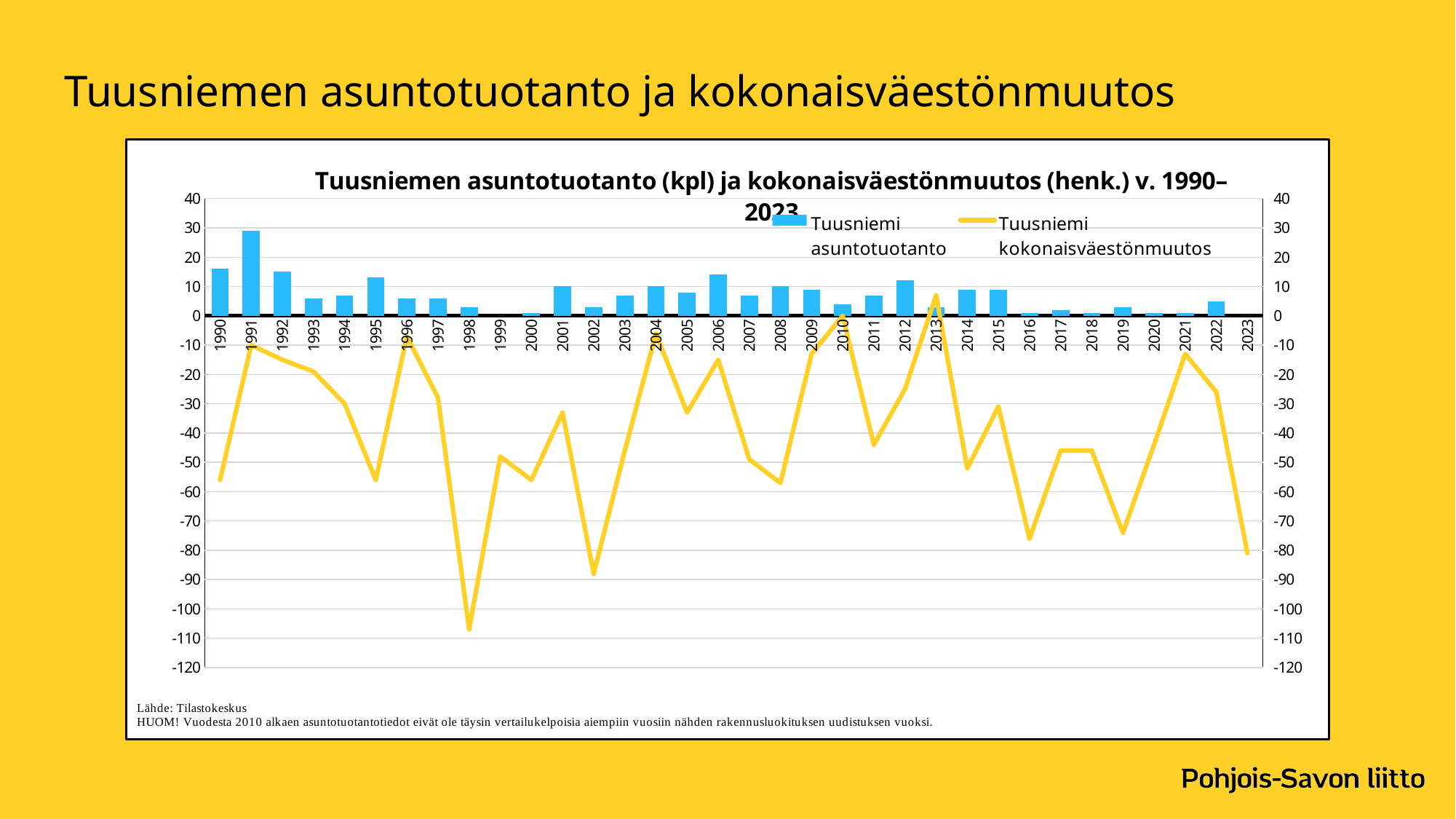
Is the Tuusniemi kokonaisväestönmuutos value for 2023 greater or less than -70? less Which year has the larger Tuusniemi asuntotuotanto bar, 2006 or 2007? 2006 In which year does the Tuusniemi kokonaisväestönmuutos line reach its highest point? 2013 In which year does the Tuusniemi kokonaisväestönmuutos line reach its lowest point? 1998 How many years are shown on the x axis? 34 Which year has the higher Tuusniemi kokonaisväestönmuutos value, 1998 or 1999? 1999 What colour is the Tuusniemi kokonaisväestönmuutos line? Yellow Is the Tuusniemi asuntotuotanto value for 1991 greater or less than 20? greater How many series does the legend list? 2 What kind of chart is shown on the slide? A combined bar and line chart Is the Tuusniemi kokonaisväestönmuutos value for 1998 greater or less than -100? less In which year is the Tuusniemi asuntotuotanto bar the highest? 1991